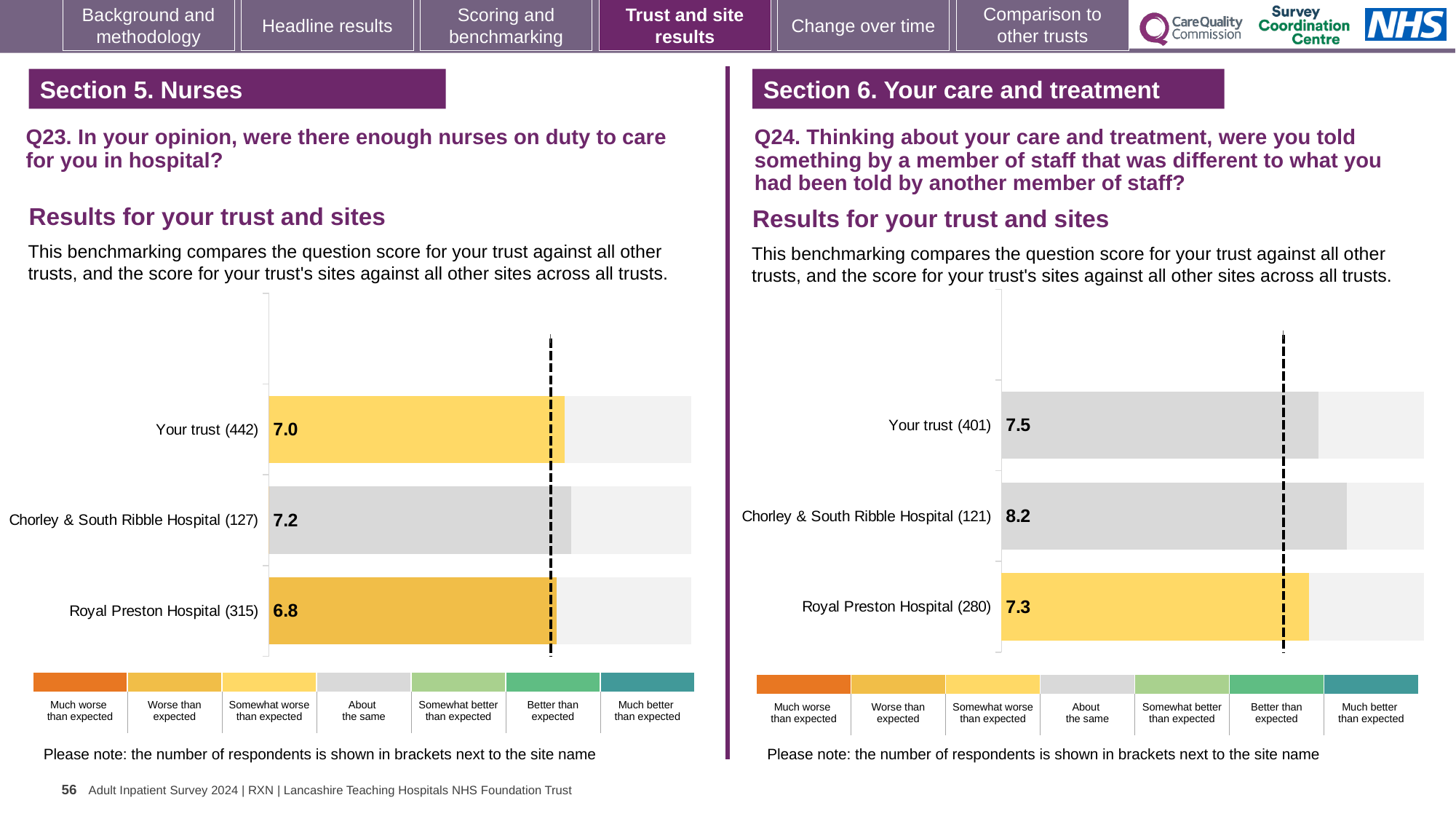
In the Q23 chart on the left, what is the score for Your trust? 7.0 In the Q23 chart on the left, what is the score for Royal Preston Hospital? 6.8 In the Q24 chart on the right, which site or trust has the lowest score? Royal Preston Hospital In the Q24 chart on the right, what is the score for Your trust? 7.5 In the Q23 chart on the left, how many bars are plotted? 3 In the Q23 chart on the left, what is the difference between the scores for Chorley & South Ribble Hospital and Royal Preston Hospital? 0.4 In the Q24 chart on the right, is the score for Chorley & South Ribble Hospital larger or smaller than the score for Royal Preston Hospital? larger In the Q24 chart on the right, what is the difference between the scores for Chorley & South Ribble Hospital and Your trust? 0.7 In the Q23 chart on the left, how many respondents are shown in brackets for Royal Preston Hospital? 315 In the Q23 chart on the left, which site or trust has the highest score? Chorley & South Ribble Hospital What kind of chart is used on the left for Q23? bar chart In the Q24 chart on the right, what is the score for Chorley & South Ribble Hospital? 8.2